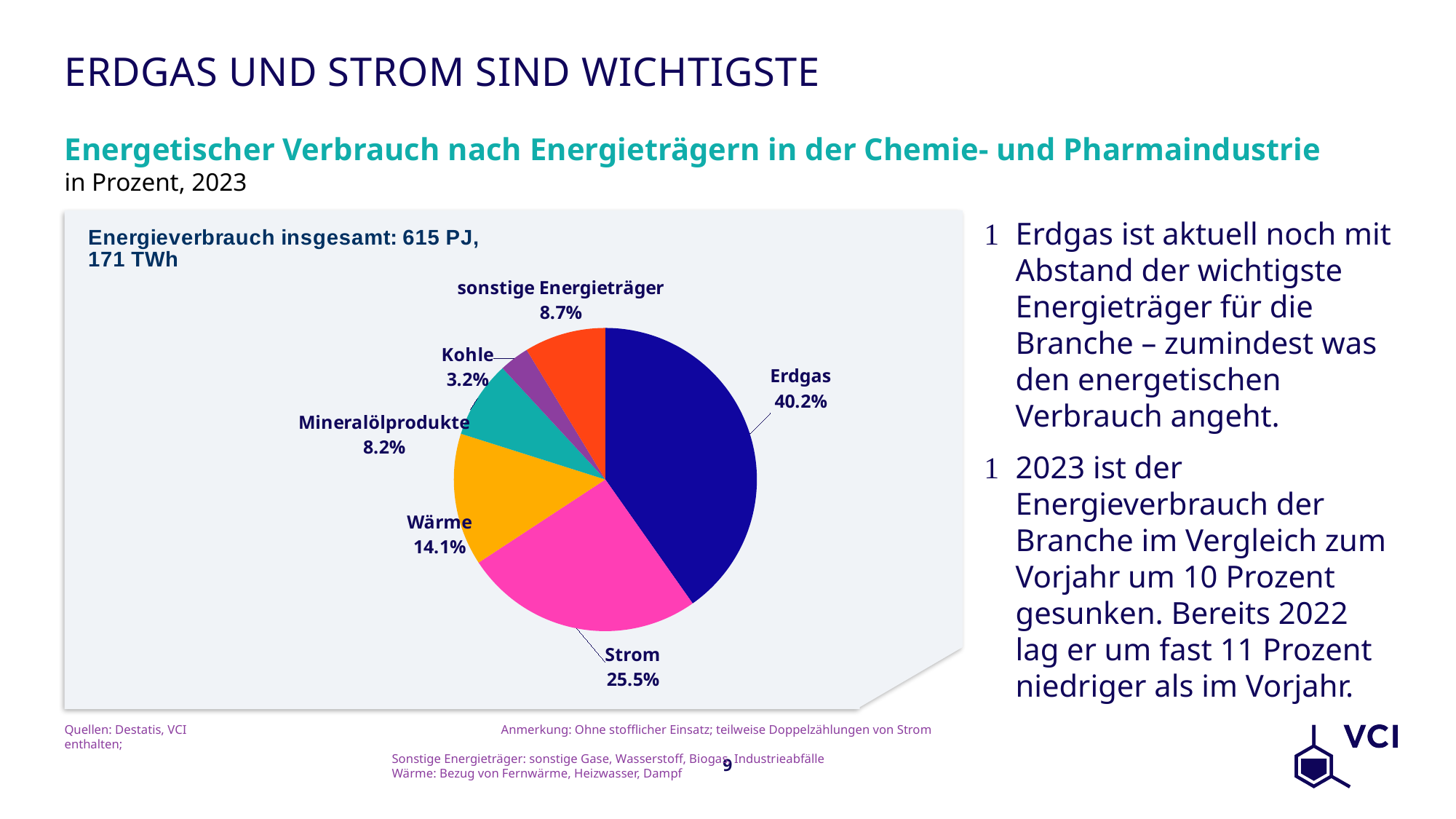
Which is larger, the share for Mineralölprodukte or the share for sonstige Energieträger? sonstige Energieträger What share is shown for sonstige Energieträger? 8.7% What total energy consumption is stated in the chart box? 615 PJ, 171 TWh What is the value for Kohle? 3.2% Which energy source has the smallest slice of the pie? Kohle How many slices does the pie chart have? 6 What percentage is shown for Wärme? 14.1% Which energy source has the largest slice of the pie? Erdgas What is the value shown for Strom? 25.5% What is the difference in percentage points between Erdgas and Strom? 14.7 What type of chart is shown on the slide? pie chart What share of energy consumption does Erdgas account for? 40.2%